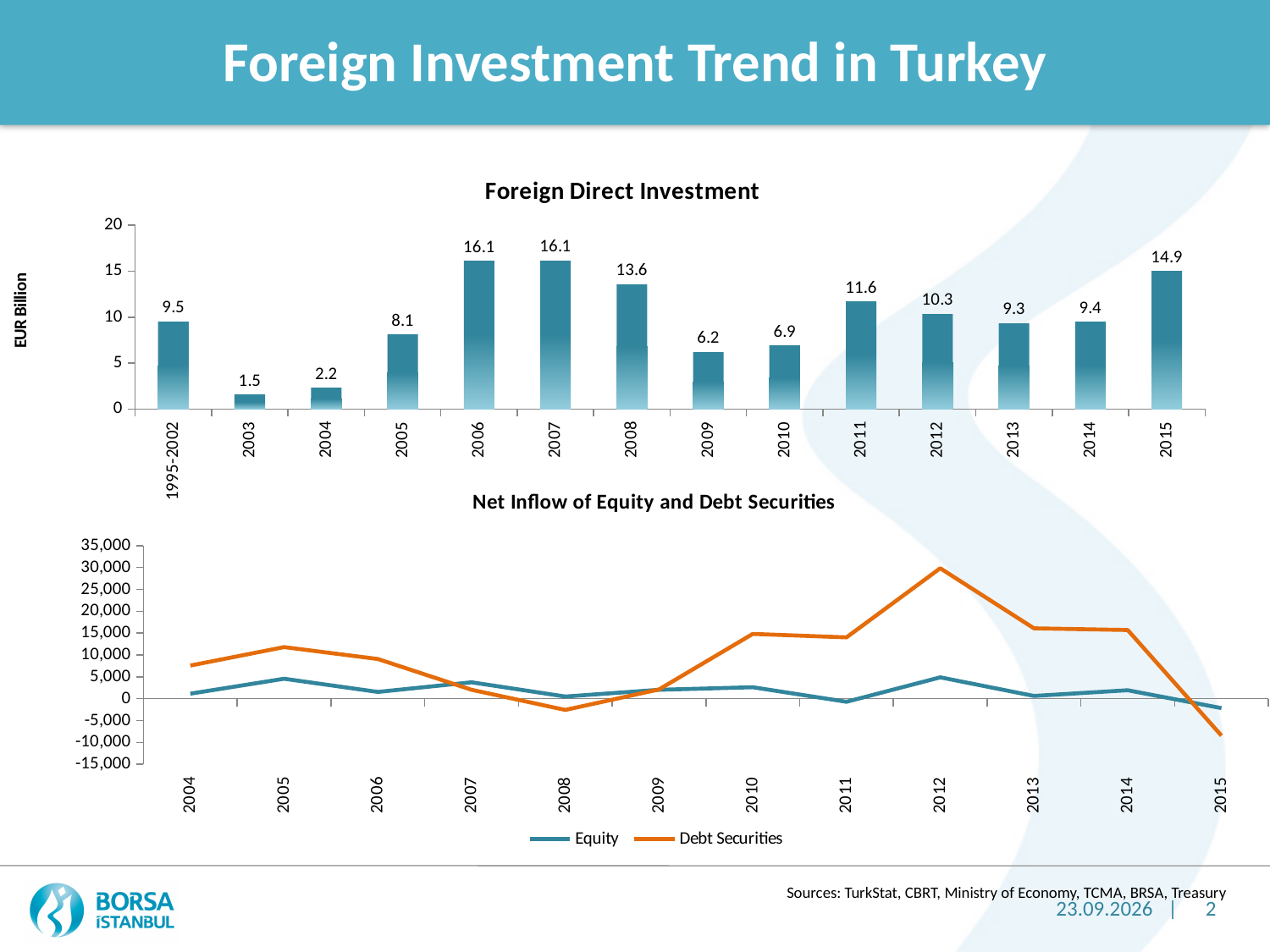
On the Net Inflow of Equity and Debt Securities chart, is the Debt Securities value for 2015 greater or less than -5,000? less On the Foreign Direct Investment chart, do the values rise or fall from 2003 to 2006? Rise On the Foreign Direct Investment chart, which is larger, the value for 2011 or the value for 2012? 2011 On the Net Inflow of Equity and Debt Securities chart, which series is shown in orange? Debt Securities On the Foreign Direct Investment chart, what is the difference between the values for 2015 and 2014? 5.5 On the Foreign Direct Investment chart, what is the value for 1995-2002? 9.5 On the Net Inflow of Equity and Debt Securities chart, how many series does the legend list? 2 On the Foreign Direct Investment chart, which year has the lowest value? 2003 On the Foreign Direct Investment chart, how many categories are shown on the x axis? 14 On the Foreign Direct Investment chart, what is the value for 2008? 13.6 What kind of chart is the Foreign Direct Investment chart? Bar chart